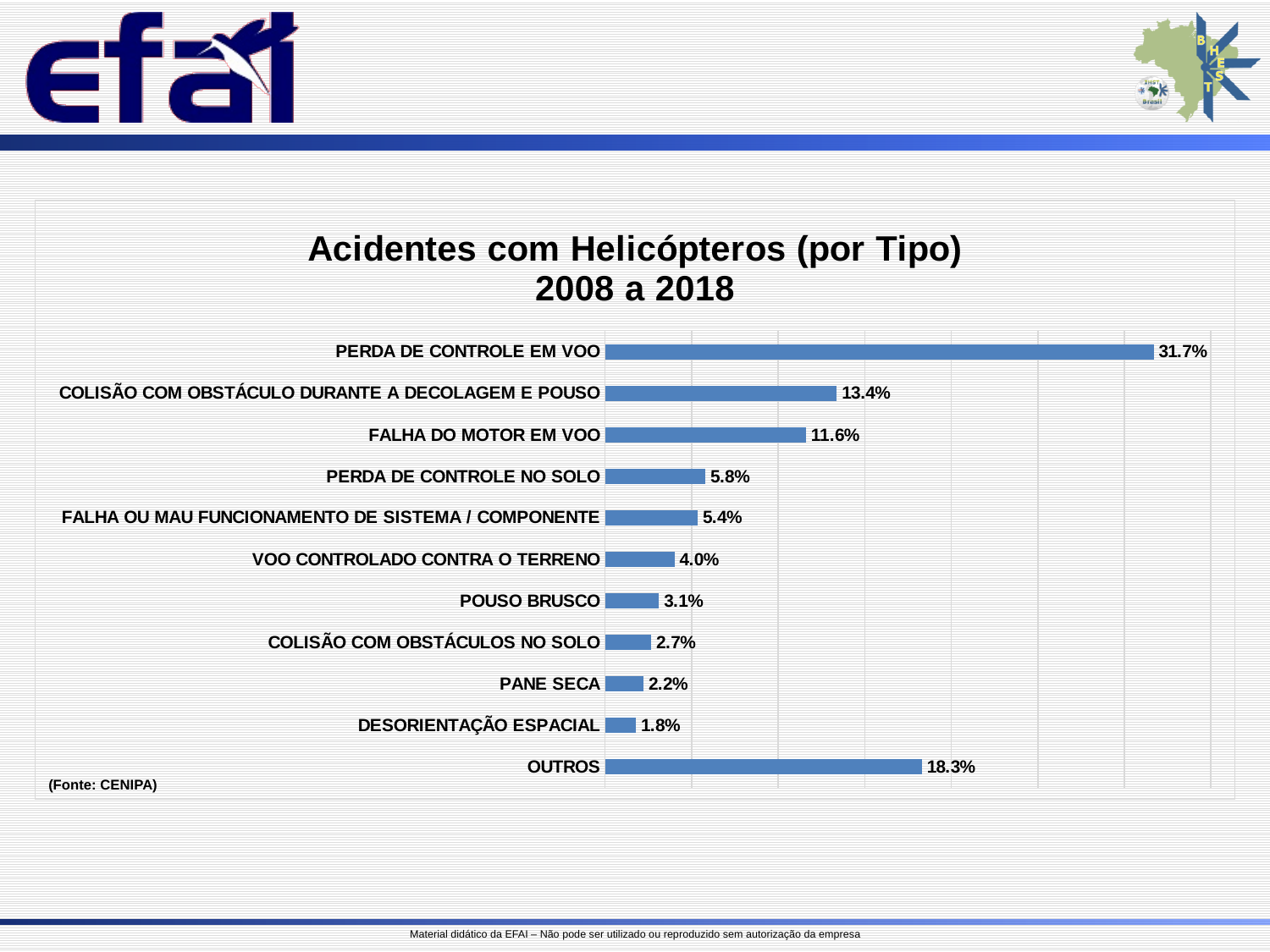
What is the difference between COLISÃO COM OBSTÁCULO DURANTE A DECOLAGEM E POUSO and FALHA DO MOTOR EM VOO? 1.8% What is the value for FALHA DO MOTOR EM VOO? 11.6% What is the value for PANE SECA? 2.2% What kind of chart is this? Bar chart What is the value for PERDA DE CONTROLE EM VOO? 31.7% Which category has the highest value? PERDA DE CONTROLE EM VOO What is the title of the chart? Acidentes com Helicópteros (por Tipo) 2008 a 2018 Which is larger, VOO CONTROLADO CONTRA O TERRENO or POUSO BRUSCO? VOO CONTROLADO CONTRA O TERRENO Which category has the lowest value? DESORIENTAÇÃO ESPACIAL How many categories are shown in the chart? 11 What is the value for OUTROS? 18.3% What is the difference between PERDA DE CONTROLE EM VOO and OUTROS? 13.4%